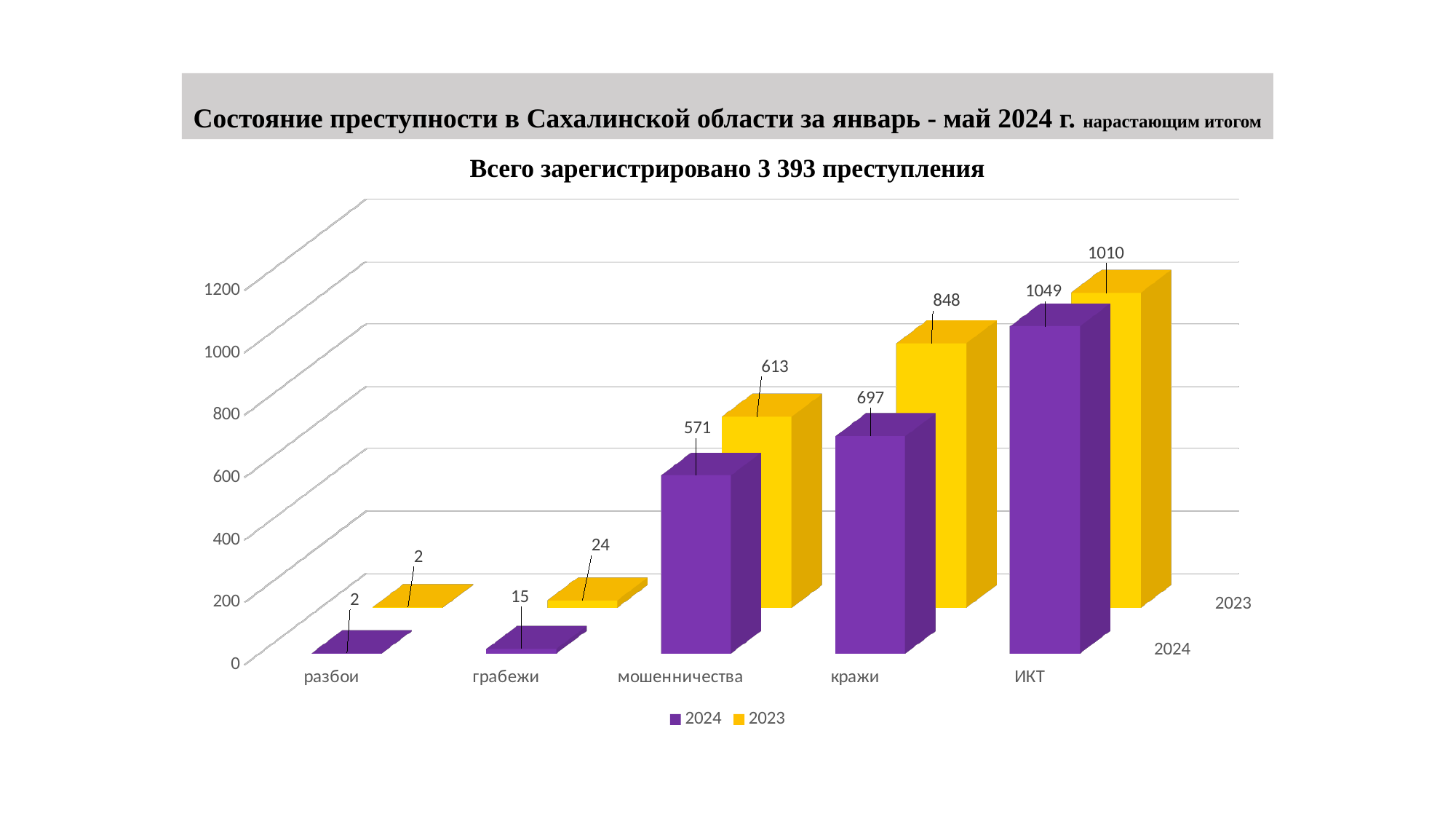
What is the difference between the 2023 and 2024 values for кражи? 151 What is the value for мошенничества in the 2023 series? 613 Is the 2024 value for мошенничества greater or less than 600? less Which is larger for ИКТ: the 2024 value or the 2023 value? 2024 What is the value for грабежи in the 2024 series? 15 What is the value for ИКТ in the 2024 series? 1049 How many series does the legend list? 2 How many categories are shown on the x axis? 5 Which category has the lowest value in the 2024 series? разбои What colour represents the 2023 series? yellow What kind of chart is shown on the slide? bar chart Which category has the highest value in the 2023 series? ИКТ